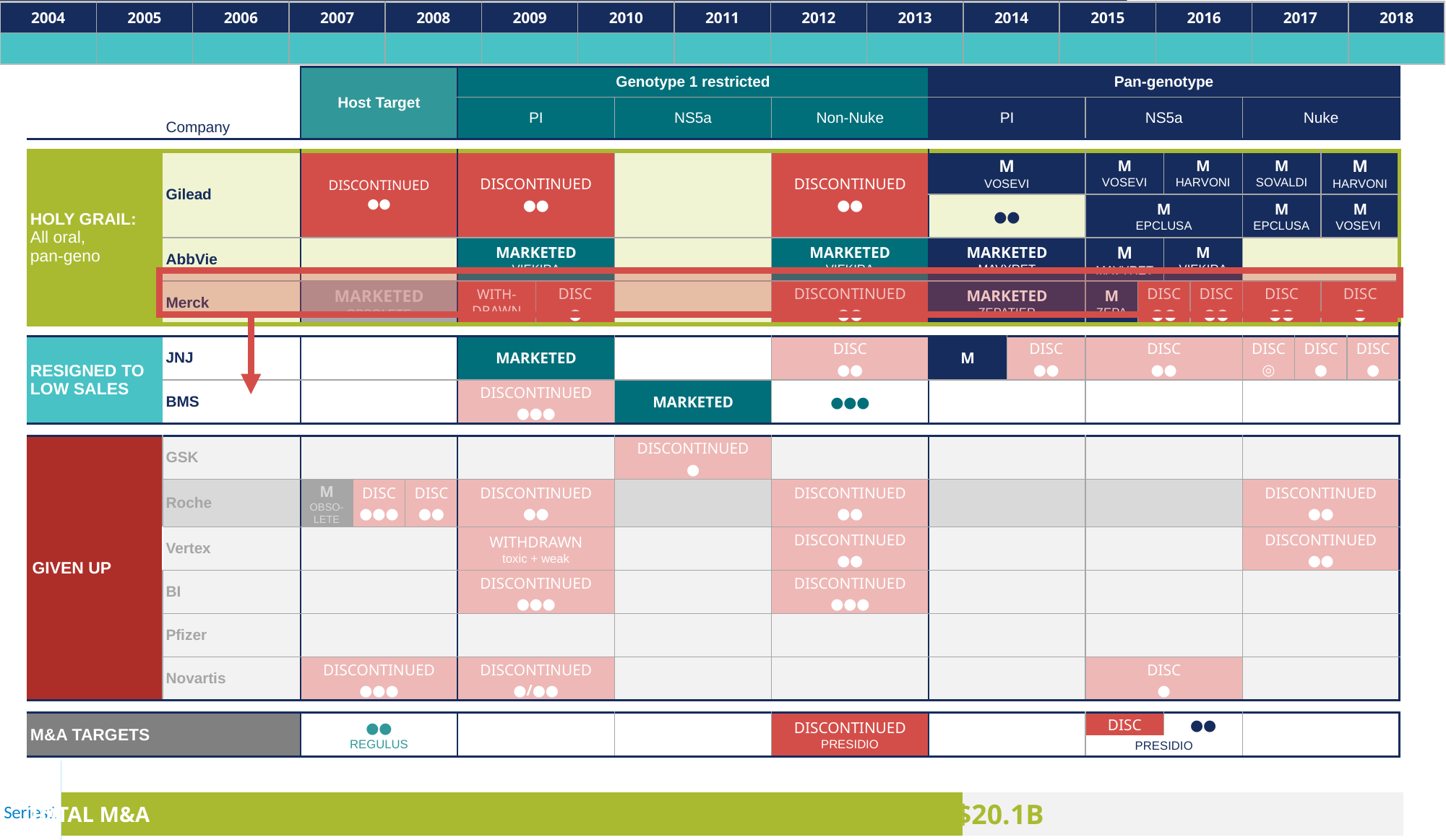
What kind of chart is shown at the bottom of the slide? bar chart What label is shown for the bar in the chart at the bottom of the slide? TOTAL M&A What colour is the bar in the chart at the bottom of the slide? green What value is printed on the bar in the chart at the bottom of the slide? $20.1B How many bars are plotted in the chart at the bottom of the slide? 2